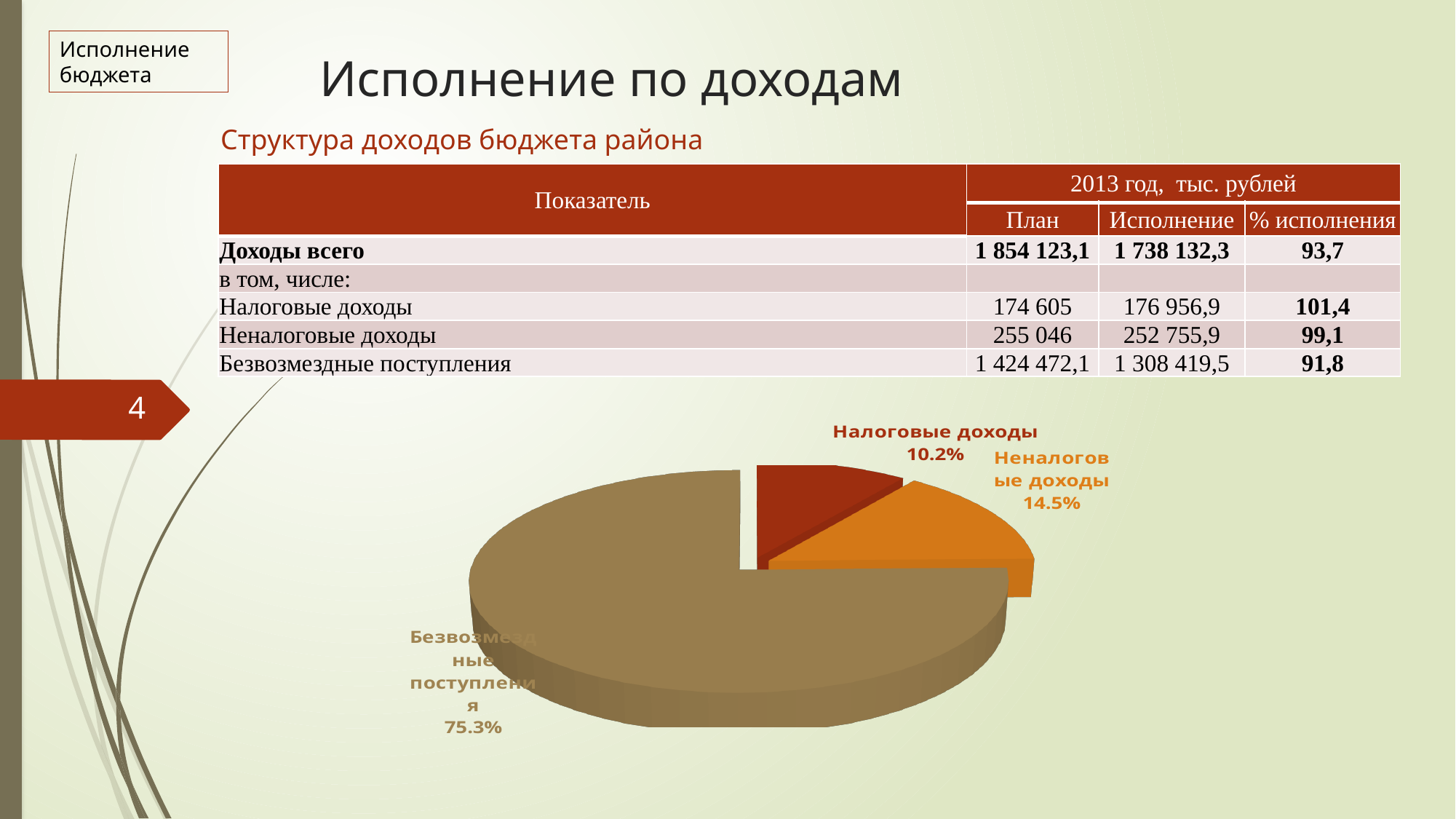
What is the difference in percentage points between the Безвозмездные поступления and Неналоговые доходы slices? 60.8 What is the difference in percentage points between the Неналоговые доходы and Налоговые доходы slices? 4.3 Which is larger in the pie chart: Неналоговые доходы or Налоговые доходы? Неналоговые доходы How many slices does the pie chart have? 3 What type of chart is shown on the slide? pie chart What share of the pie chart is Безвозмездные поступления? 75.3% Which slice of the pie chart is the smallest? Налоговые доходы Which slice of the pie chart is the largest? Безвозмездные поступления What share of the pie chart is Неналоговые доходы? 14.5% What colour is the Налоговые доходы slice in the pie chart? dark red What share of the pie chart is Налоговые доходы? 10.2% What colour is the Безвозмездные поступления slice in the pie chart? brown